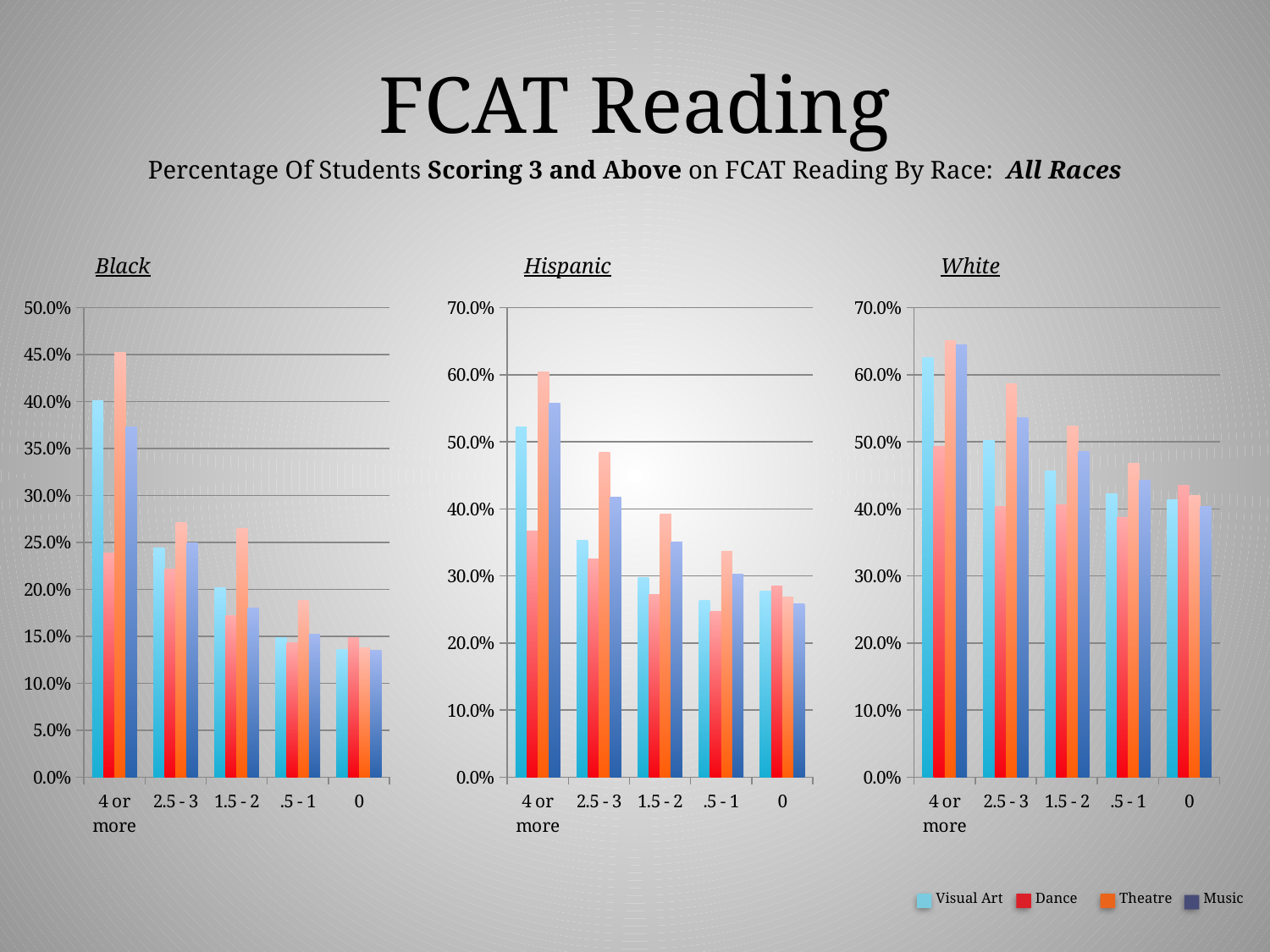
In the White chart, do the Visual Art values rise or fall from '4 or more' to '0'? fall In the Black chart, is the Theatre value for '4 or more' greater or less than 40.0%? greater In the White chart, is the Visual Art value for '4 or more' greater or less than 60.0%? greater In the Hispanic chart, is the Dance value for '4 or more' greater or less than 40.0%? less Which series is shown in light blue in the legend? Visual Art In the Black chart, which series has the highest value for '4 or more'? Theatre What kind of chart is the Black chart? bar chart How many categories are shown on the x axis of the Hispanic chart? 5 How many series does the legend list? 4 In the Hispanic chart, which category has the lowest Dance value? .5 - 1 In the Black chart, which is larger for '1.5 - 2', Dance or Theatre? Theatre